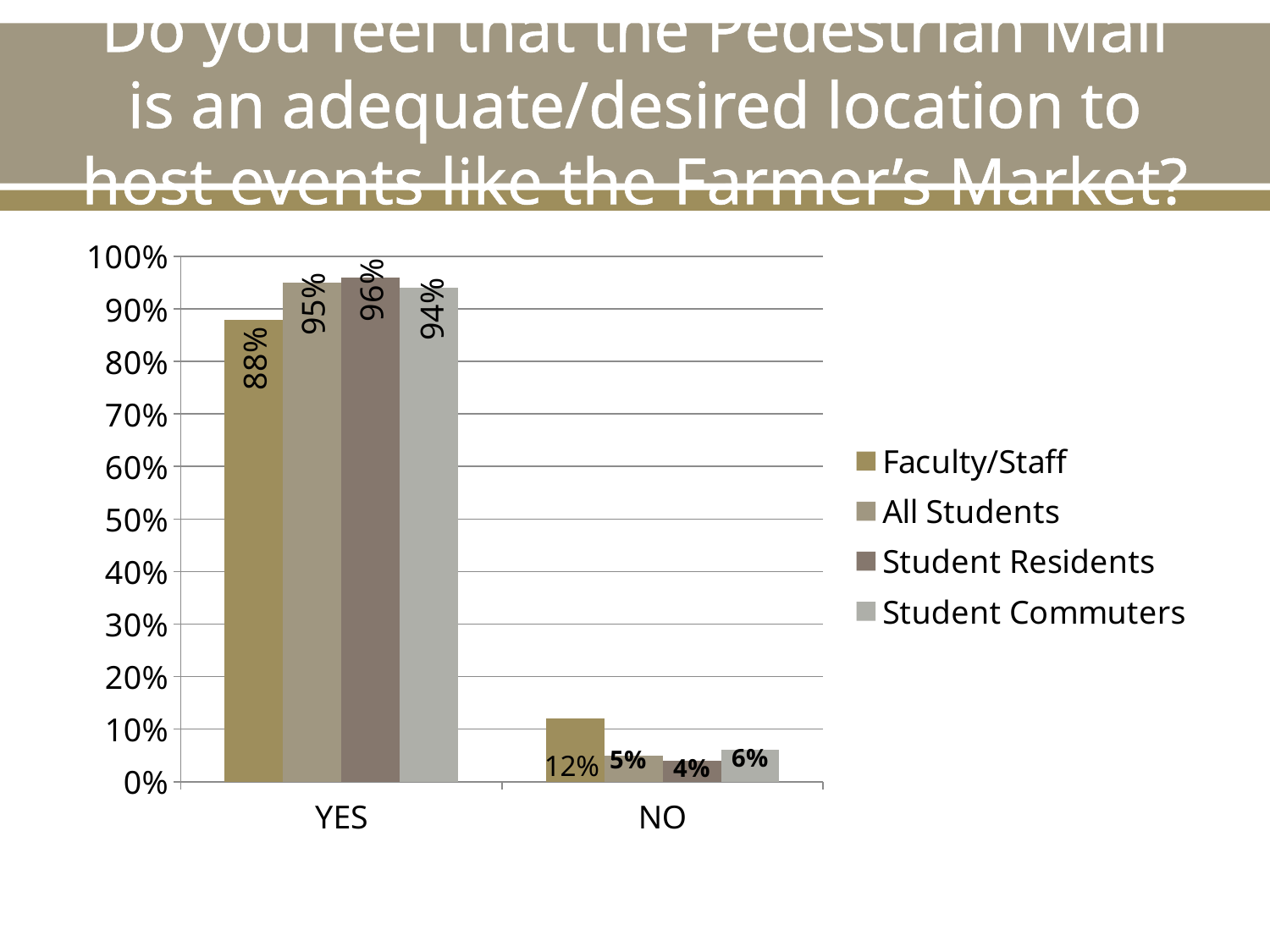
How many series does the legend list? 4 What kind of chart is shown on the slide? Bar chart Which is larger: the YES percentage for All Students or for Student Commuters? All Students Which group has the highest YES percentage? Student Residents What percentage of Student Residents answered NO? 4% Which group has the highest NO percentage? Faculty/Staff What percentage of All Students answered NO? 5% What is the difference between the Faculty/Staff NO percentage and the Student Residents NO percentage? 8% What percentage of Faculty/Staff answered YES? 88% What percentage of Student Commuters answered YES? 94% How many categories are shown on the x axis? 2 Which group has the lowest YES percentage? Faculty/Staff